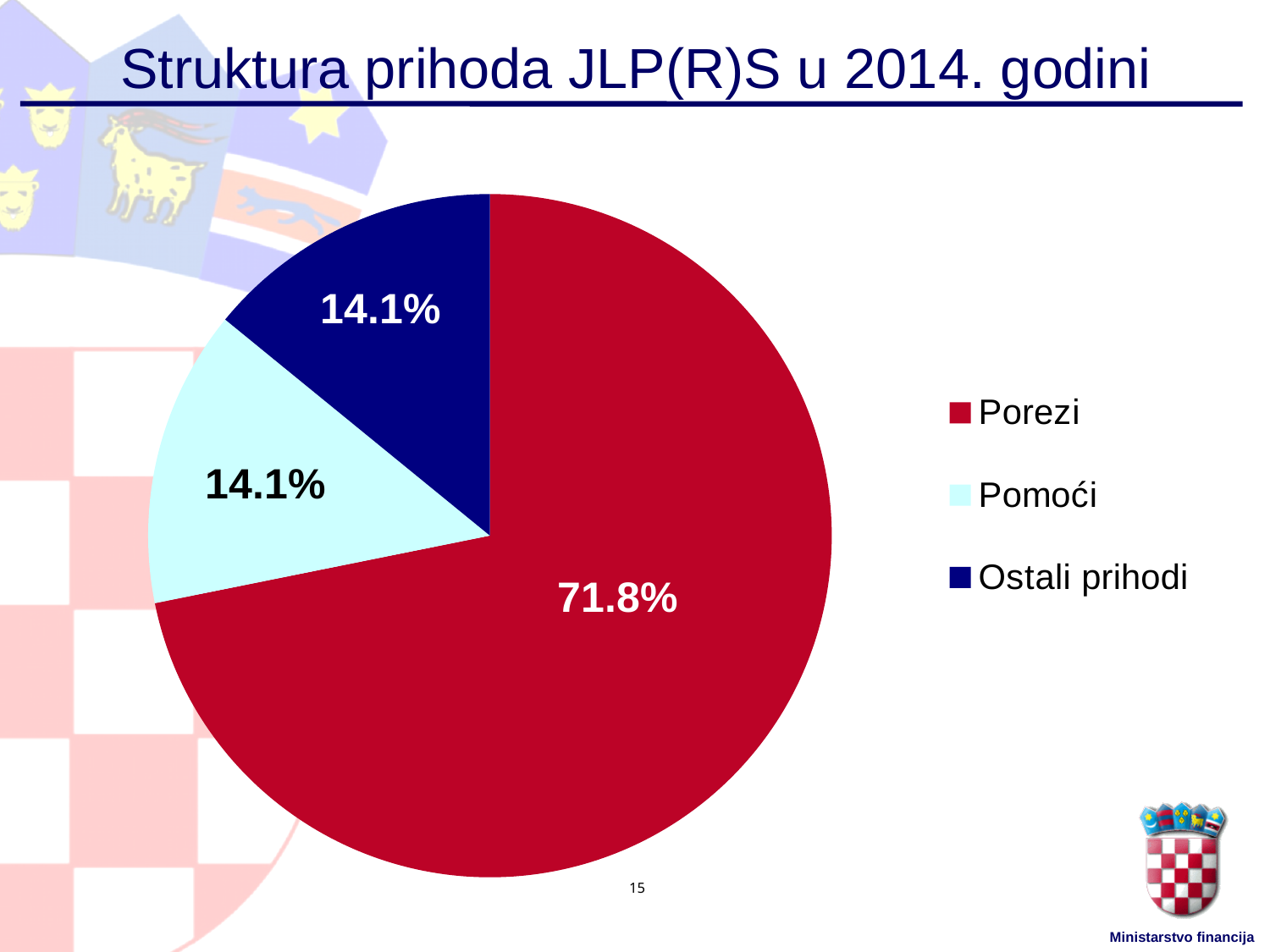
What kind of chart is shown on the slide? Pie chart Which category has the largest slice of the pie? Porezi How many entries does the legend list? 3 What is the value shown for Pomoći? 14.1% What is the title of the chart on the slide? Struktura prihoda JLP(R)S u 2014. godini Which is larger, the slice for Porezi or the slice for Ostali prihodi? Porezi How many slices does the pie chart have? 3 Is the share for Porezi greater or less than 50%? greater What is the difference in percentage points between Porezi and Pomoći? 57.7 What is the value shown for Ostali prihodi? 14.1% What share of the pie does Porezi represent? 71.8% Which category is shown in dark blue in the legend? Ostali prihodi